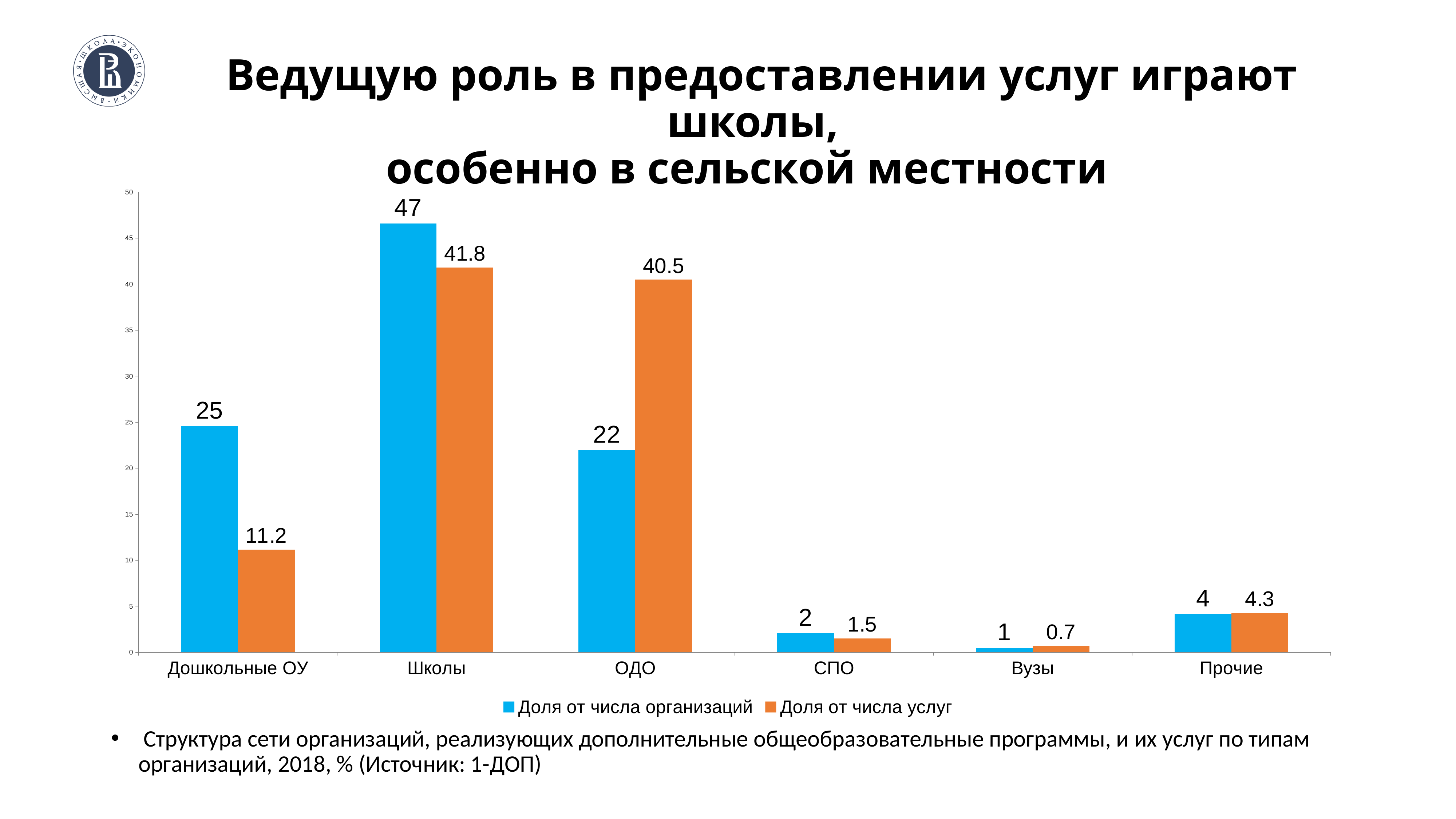
What is the value of 'Доля от числа услуг' for Дошкольные ОУ? 11.2 What is the value of 'Доля от числа организаций' for Школы? 47 What is the value of 'Доля от числа услуг' for ОДО? 40.5 Which colour represents the series 'Доля от числа услуг'? orange For Дошкольные ОУ, which is larger: 'Доля от числа организаций' or 'Доля от числа услуг'? Доля от числа организаций How many series does the legend list? 2 Which category has the lowest value for 'Доля от числа услуг'? Вузы What is the difference between 'Доля от числа организаций' and 'Доля от числа услуг' for Школы? 5.2 What is the difference between 'Доля от числа услуг' and 'Доля от числа организаций' for ОДО? 18.5 What type of chart is shown on the slide? bar chart Which category has the highest value for 'Доля от числа организаций'? Школы How many categories are shown on the x axis? 6